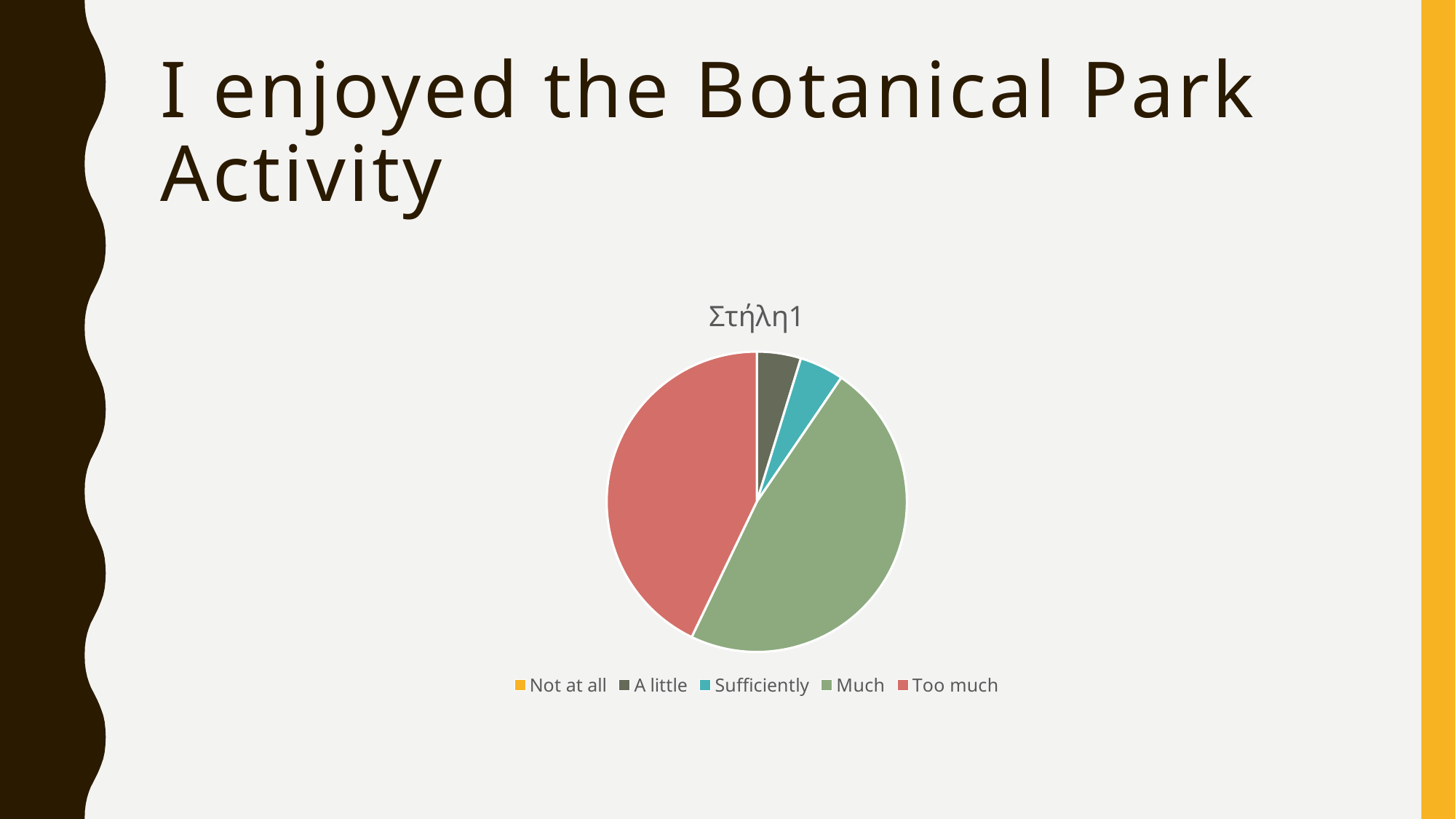
Which slice is larger in the pie chart, Much or Sufficiently? Much How many data series does the pie chart show? 1 How many categories does the legend of the pie chart list? 5 What kind of chart is shown on the slide? Pie chart What colour is the Too much slice in the pie chart? Red Which slice is larger in the pie chart, Much or A little? Much What is the title shown above the pie chart? Στήλη1 Which legend category has no visible slice in the pie chart? Not at all Which slice is larger in the pie chart, Too much or Sufficiently? Too much